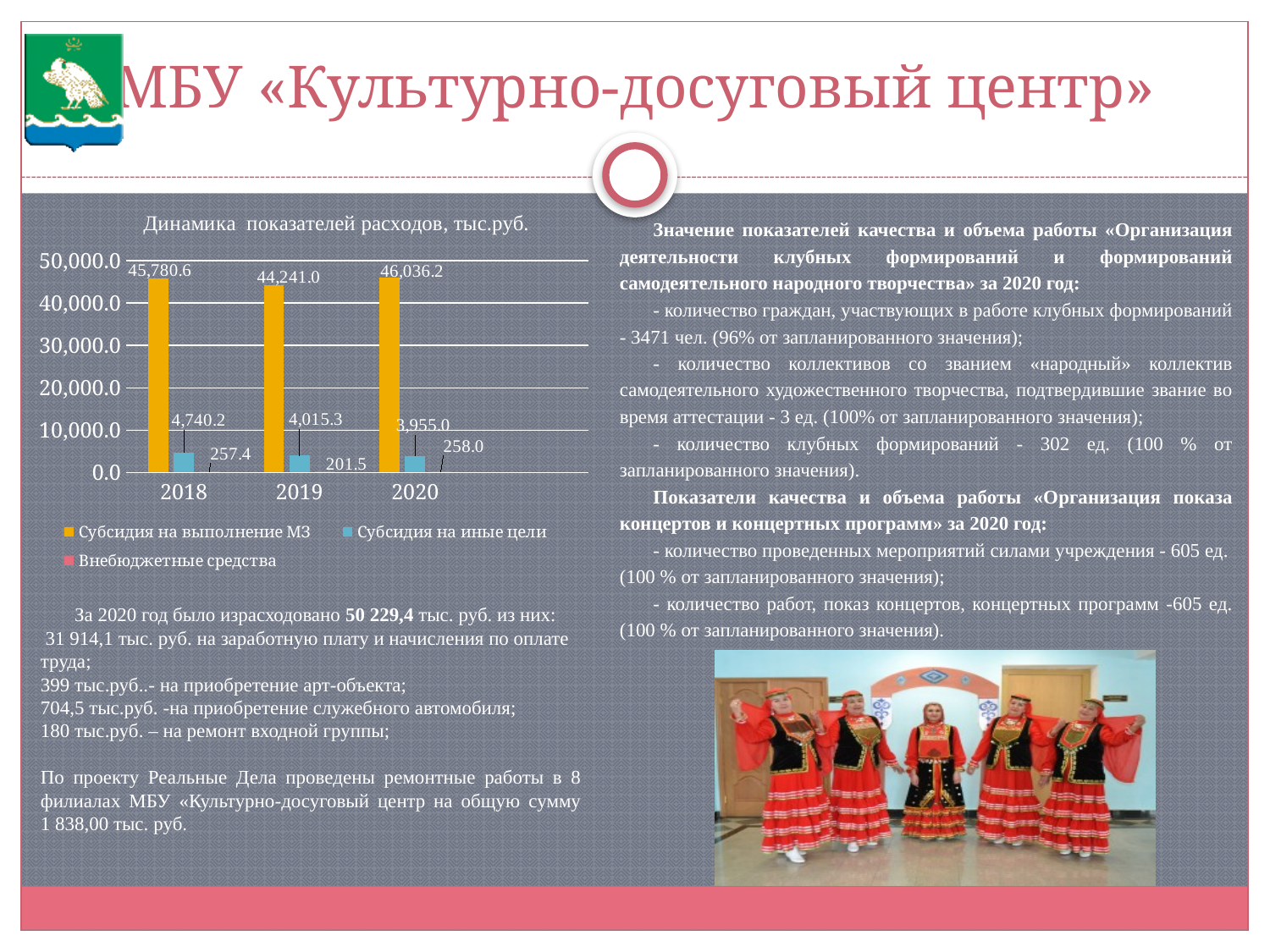
What is the value of Субсидия на выполнение МЗ for 2018? 45,780.6 In which year is Субсидия на выполнение МЗ the lowest? 2019 What is the value of Субсидия на иные цели for 2019? 4,015.3 What is the value of Субсидия на выполнение МЗ for 2020? 46,036.2 How many years are shown on the x axis of the chart? 3 How many series does the chart legend list? 3 In which year is Субсидия на иные цели the highest? 2018 Is the value of Субсидия на выполнение МЗ for 2019 greater or less than 40,000.0? greater What is the value of Внебюджетные средства for 2020? 258.0 What is the difference between Субсидия на выполнение МЗ in 2020 and in 2019? 1,795.2 Which is larger: Внебюджетные средства in 2018 or in 2019? 2018 What type of chart is shown on the slide? Bar chart